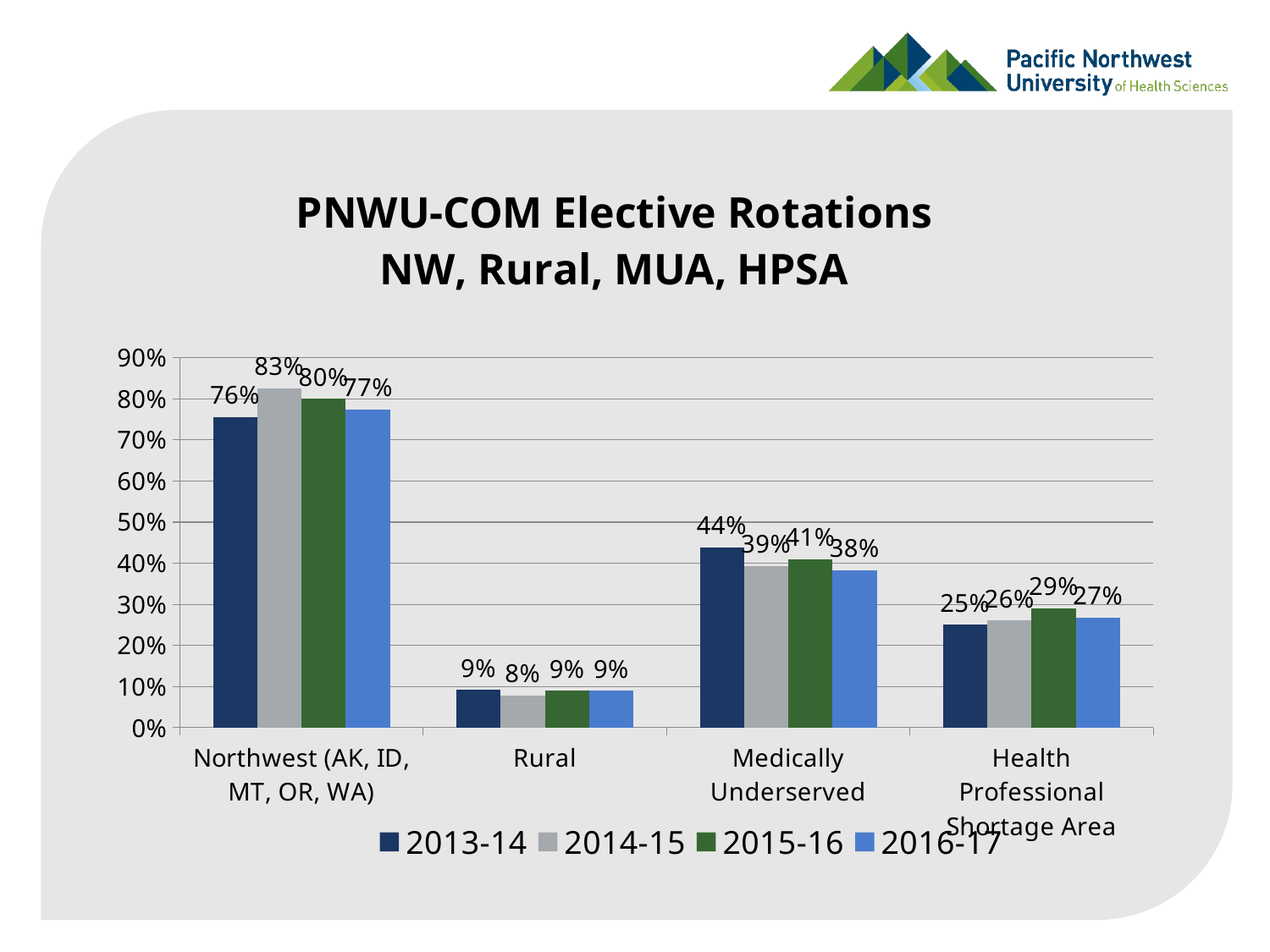
What is the value for Northwest (AK, ID, MT, OR, WA) in 2014-15? 83% Which is larger for Medically Underserved: the 2013-14 value or the 2016-17 value? 2013-14 What is the value for Rural in 2014-15? 8% What is the value for Medically Underserved in 2013-14? 44% How many series does the legend list? 4 What kind of chart is shown on the slide? Bar chart How many categories are shown on the x axis? 4 What is the value for Health Professional Shortage Area in 2015-16? 29% Which category has the highest value in 2016-17? Northwest (AK, ID, MT, OR, WA) Is the value for Medically Underserved in 2015-16 greater or less than 50%? less What is the difference between the 2014-15 and 2013-14 values for Northwest (AK, ID, MT, OR, WA)? 7% Which category has the lowest value in 2013-14? Rural